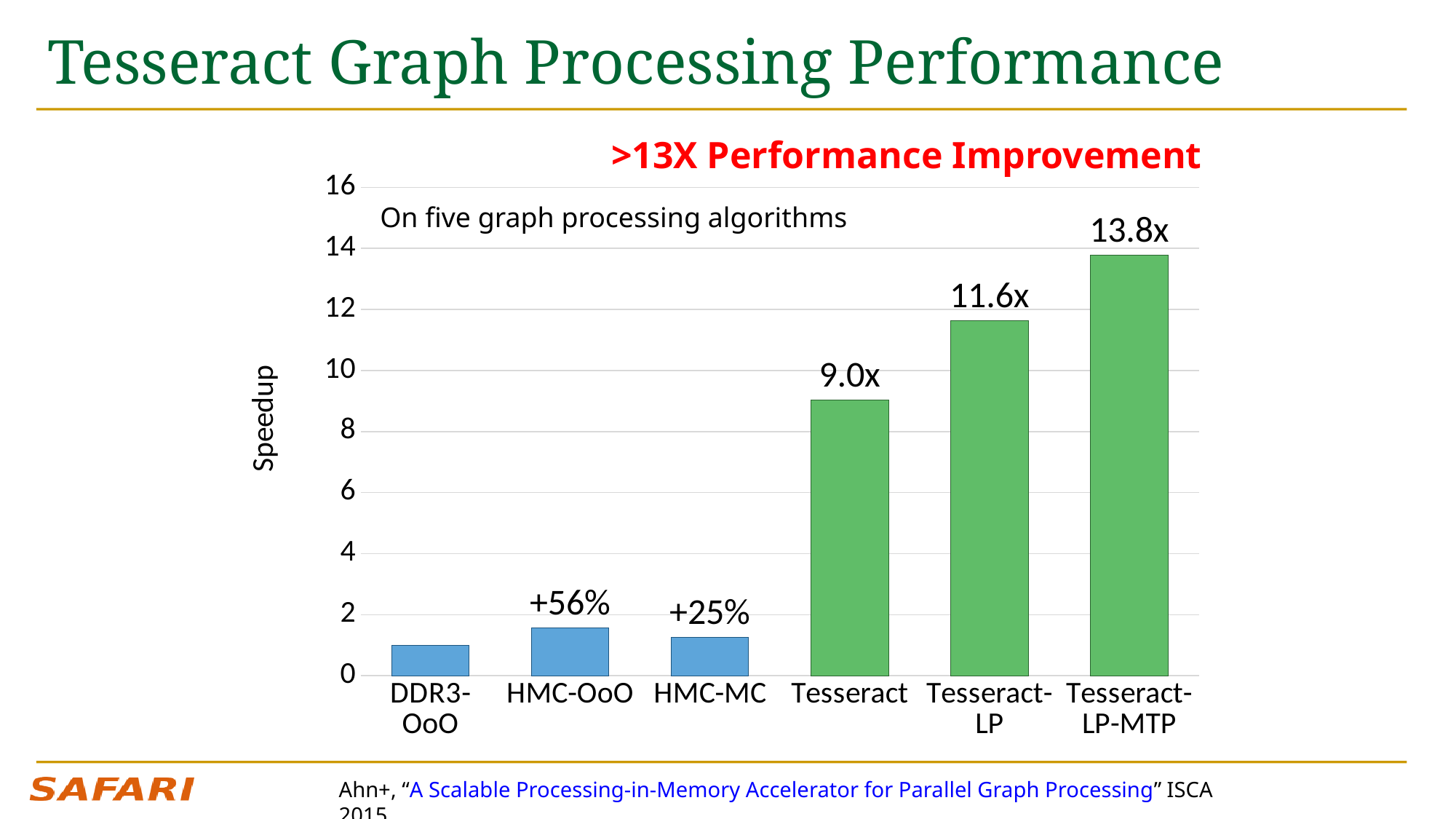
How many configurations are shown on the x axis? 6 Which configuration has the highest speedup? Tesseract-LP-MTP What is the speedup value shown for Tesseract-LP? 11.6x What is the difference in speedup between Tesseract-LP-MTP and Tesseract-LP? 2.2x What kind of chart is shown on the slide? bar chart Which has a larger speedup, HMC-OoO or Tesseract? Tesseract What is the label on the y axis of the chart? Speedup What is the difference in speedup between Tesseract-LP and Tesseract? 2.6x Is the speedup for DDR3-OoO greater or less than 2? less What is the speedup value shown for Tesseract-LP-MTP? 13.8x Which configuration has the lowest speedup? DDR3-OoO What is the speedup value shown for Tesseract? 9.0x